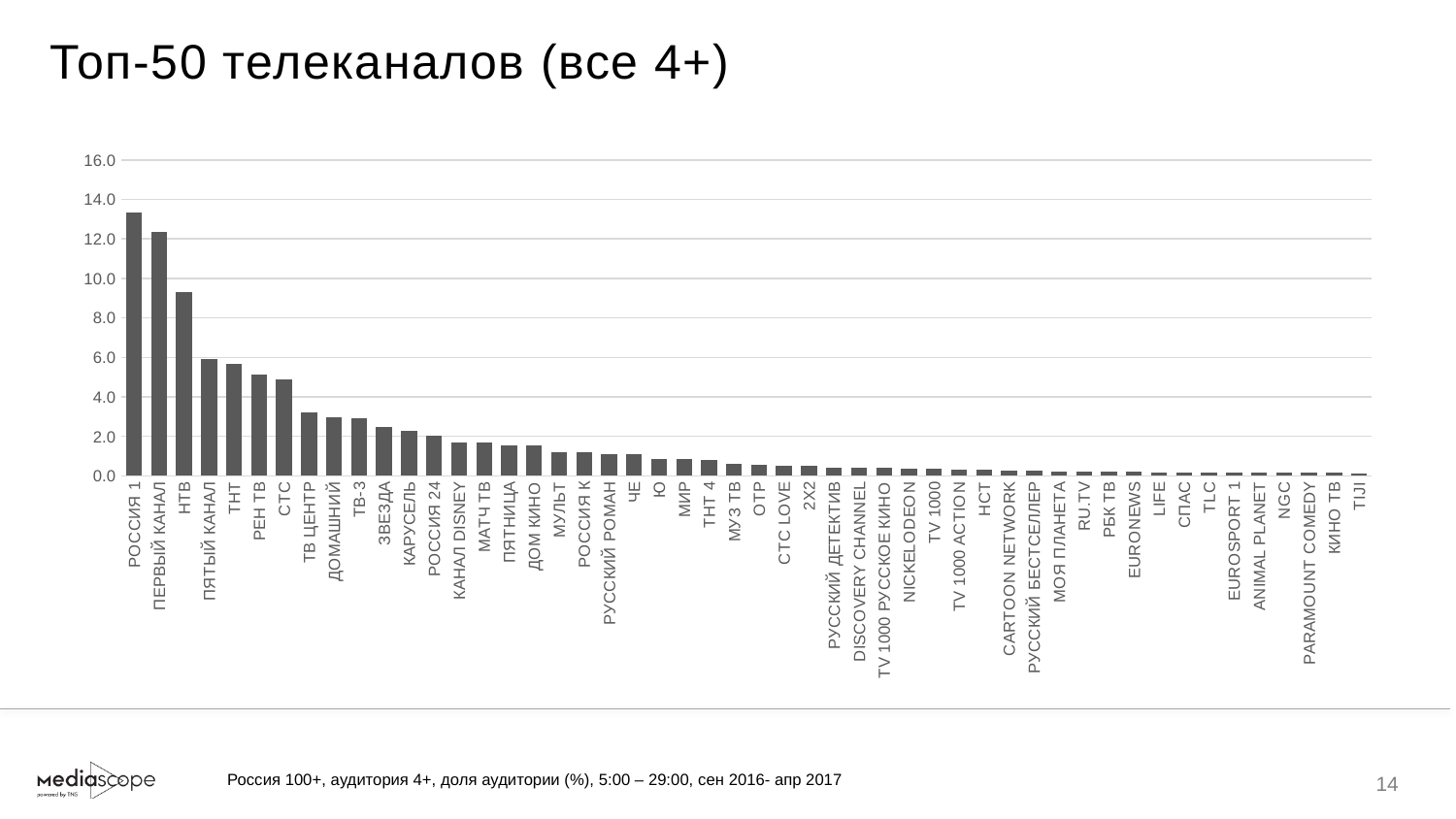
How many channels are shown in the chart? 50 Is the value for РОССИЯ 1 greater or less than 12.0? greater Which has a larger value, РОССИЯ 1 or ПЕРВЫЙ КАНАЛ? РОССИЯ 1 What is the highest value shown on the vertical axis? 16.0 Which has a larger value, НТВ or ТНТ? НТВ Which channel has the highest value in the chart? РОССИЯ 1 Is the value for НТВ greater or less than 10.0? less Do the values rise or fall from left to right along the x axis? fall Is the value for ПЯТЫЙ КАНАЛ greater or less than 4.0? greater What kind of chart is shown on the slide? bar chart What is the title of the chart? Топ-50 телеканалов (все 4+)